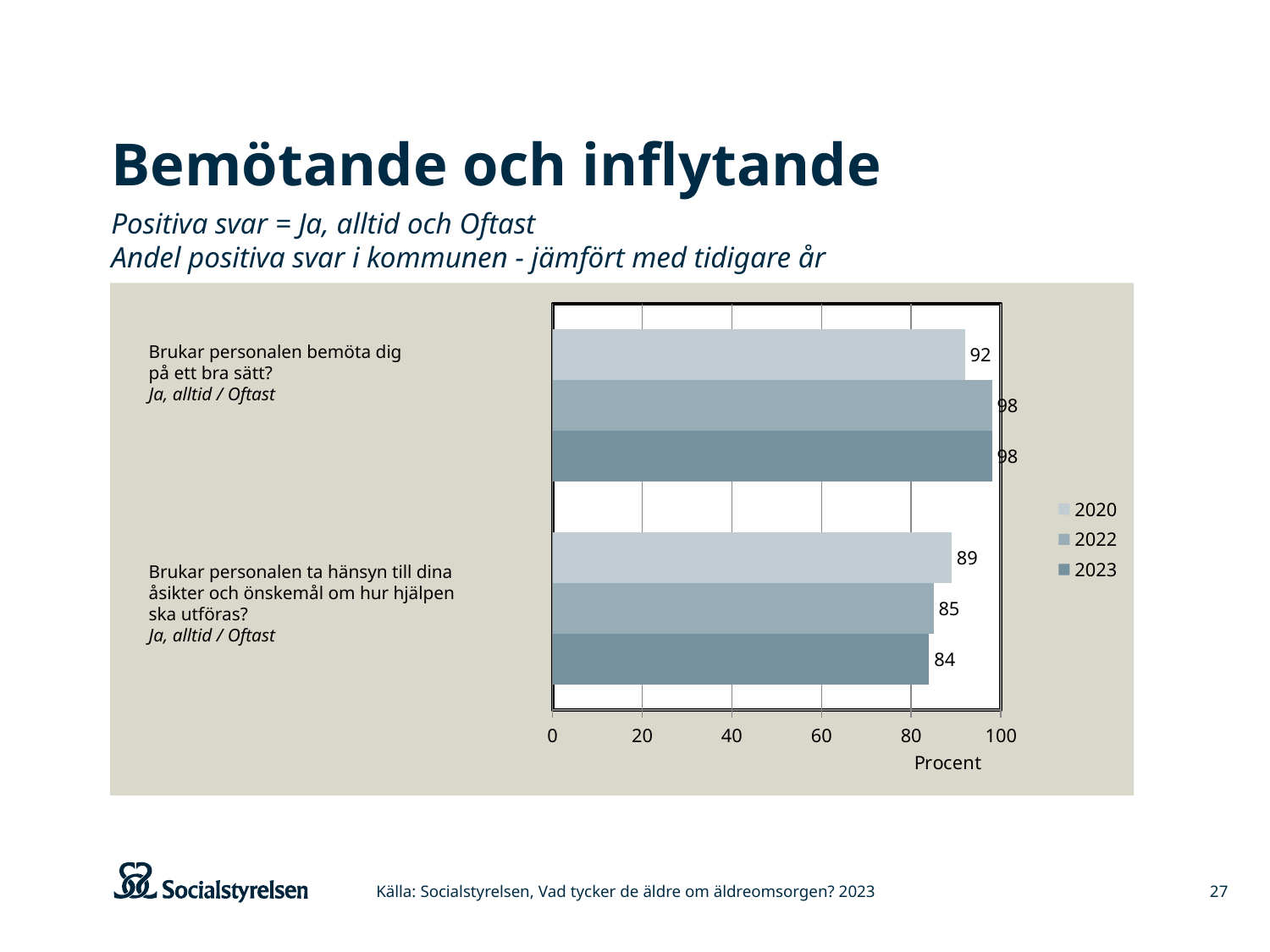
How many series does the legend list? 3 What is the 2023 value for "Brukar personalen bemöta dig på ett bra sätt?"? 98 Which year has the lowest value for "Brukar personalen ta hänsyn till dina åsikter och önskemål om hur hjälpen ska utföras?"? 2023 Which year has the lowest value for "Brukar personalen bemöta dig på ett bra sätt?"? 2020 Which is larger for "Brukar personalen ta hänsyn till dina åsikter och önskemål om hur hjälpen ska utföras?": the 2020 value or the 2023 value? 2020 What kind of chart is shown on the slide? bar chart What label is shown on the horizontal axis of the chart? Procent What is the 2023 value for "Brukar personalen ta hänsyn till dina åsikter och önskemål om hur hjälpen ska utföras?"? 84 What is the 2022 value for "Brukar personalen ta hänsyn till dina åsikter och önskemål om hur hjälpen ska utföras?"? 85 What is the 2020 value for "Brukar personalen bemöta dig på ett bra sätt?"? 92 How many question categories are plotted on the chart? 2 What is the difference between the 2022 and 2020 values for "Brukar personalen bemöta dig på ett bra sätt?"? 6